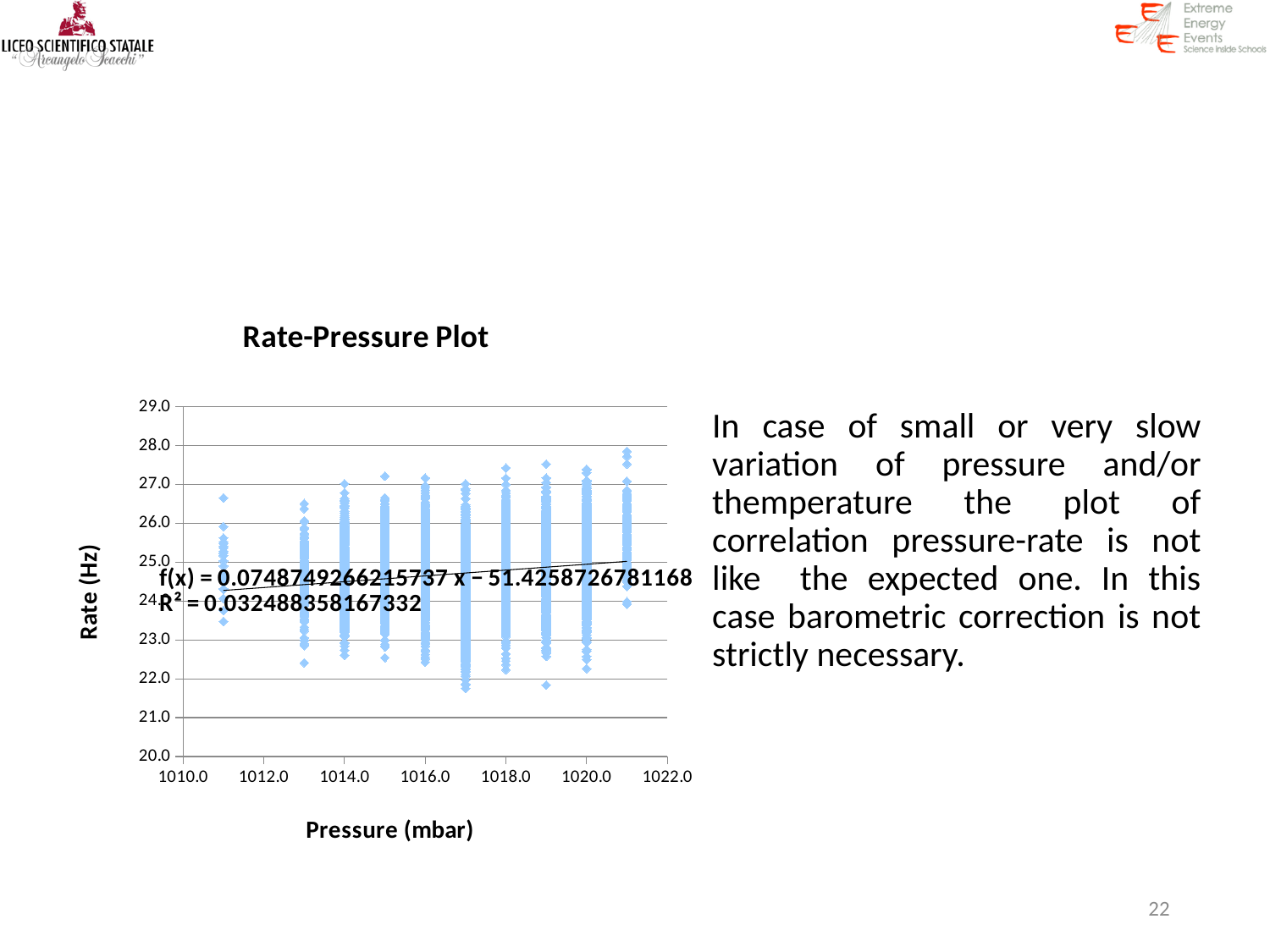
What is the R² value shown on the chart? 0.032488358167332 What is the highest value shown on the y axis of the chart? 29.0 What is the lowest value shown on the x axis of the chart? 1010.0 What is the trendline equation shown on the chart? f(x) = 0.0748749266215737 x − 51.4258726781168 Is the highest rate value at a pressure of 1011.0 mbar greater or less than 27.0 Hz? less What kind of chart is shown on the slide? scatter plot Is the highest rate value at a pressure of 1021.0 mbar greater or less than 27.0 Hz? greater Does the trendline rise or fall as pressure increases along the x axis? rise What is the title of the chart? Rate-Pressure Plot What is the slope of the trendline shown on the chart? 0.0748749266215737 Is the lowest rate value at a pressure of 1011.0 mbar greater or less than 23.0 Hz? greater What is the label of the x axis of the chart? Pressure (mbar)